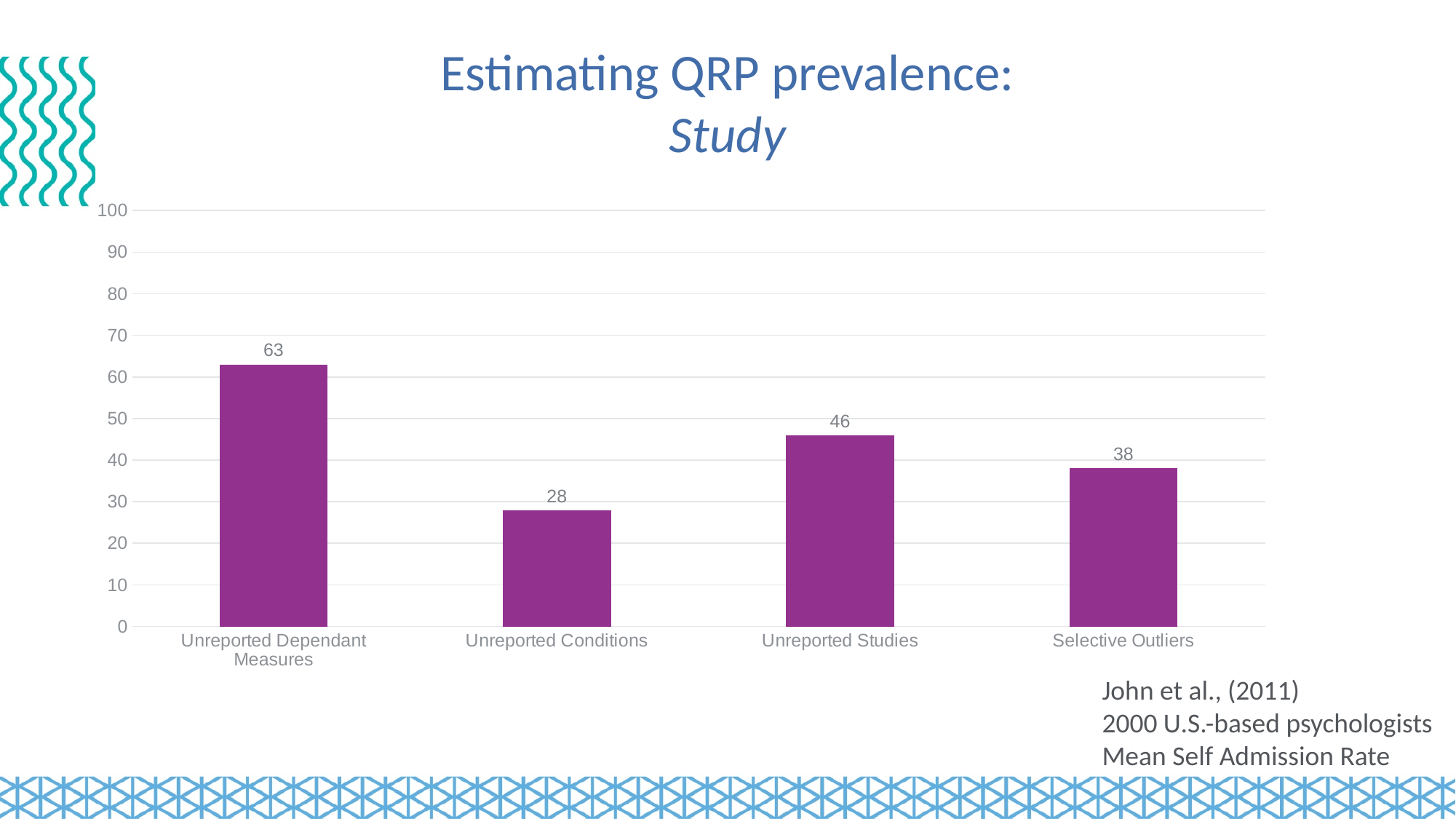
What kind of chart is shown on the slide? bar chart What is the value for Unreported Studies? 46 Which category has the highest value? Unreported Dependant Measures How many categories are shown on the chart? 4 What is the value for Selective Outliers? 38 What is the difference between the values for Unreported Dependant Measures and Unreported Conditions? 35 What is the value for Unreported Conditions? 28 Which category has the lowest value? Unreported Conditions Is the value for Selective Outliers greater or less than 40? less What is the value for Unreported Dependant Measures? 63 What is the difference between the values for Unreported Studies and Selective Outliers? 8 Which is larger, the value for Unreported Studies or the value for Selective Outliers? Unreported Studies